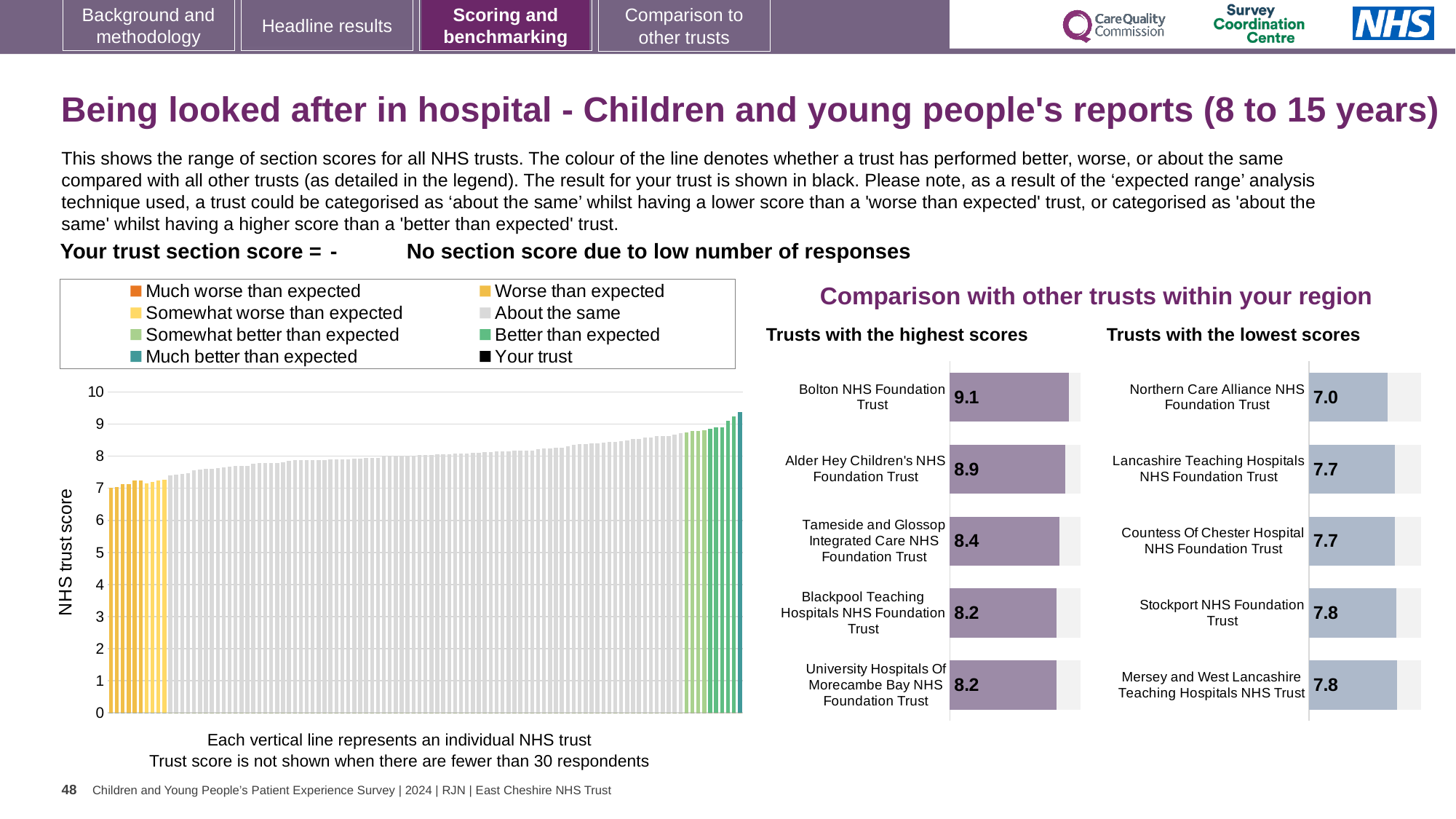
In the 'Trusts with the highest scores' chart, what is the score for Bolton NHS Foundation Trust? 9.1 In the 'Trusts with the lowest scores' chart, which trust has the lowest score? Northern Care Alliance NHS Foundation Trust In the 'Trusts with the highest scores' chart, which trust has the highest score? Bolton NHS Foundation Trust In the 'Trusts with the highest scores' chart, what is the difference between the scores of Bolton NHS Foundation Trust and Alder Hey Children's NHS Foundation Trust? 0.2 How many entries does the legend above the large chart on the left list? 8 How many trusts are shown in the 'Trusts with the highest scores' chart? 5 What kind of chart is the large chart on the left showing NHS trust scores? Bar chart In the 'Trusts with the lowest scores' chart, what is the score for Northern Care Alliance NHS Foundation Trust? 7.0 In the large chart on the left, do the trust scores rise or fall from left to right? Rise In the 'Trusts with the lowest scores' chart, what is the difference between the scores of Stockport NHS Foundation Trust and Northern Care Alliance NHS Foundation Trust? 0.8 In the 'Trusts with the highest scores' chart, which has the higher score: Tameside and Glossop Integrated Care NHS Foundation Trust or Blackpool Teaching Hospitals NHS Foundation Trust? Tameside and Glossop Integrated Care NHS Foundation Trust In the 'Trusts with the lowest scores' chart, what is the score for Stockport NHS Foundation Trust? 7.8